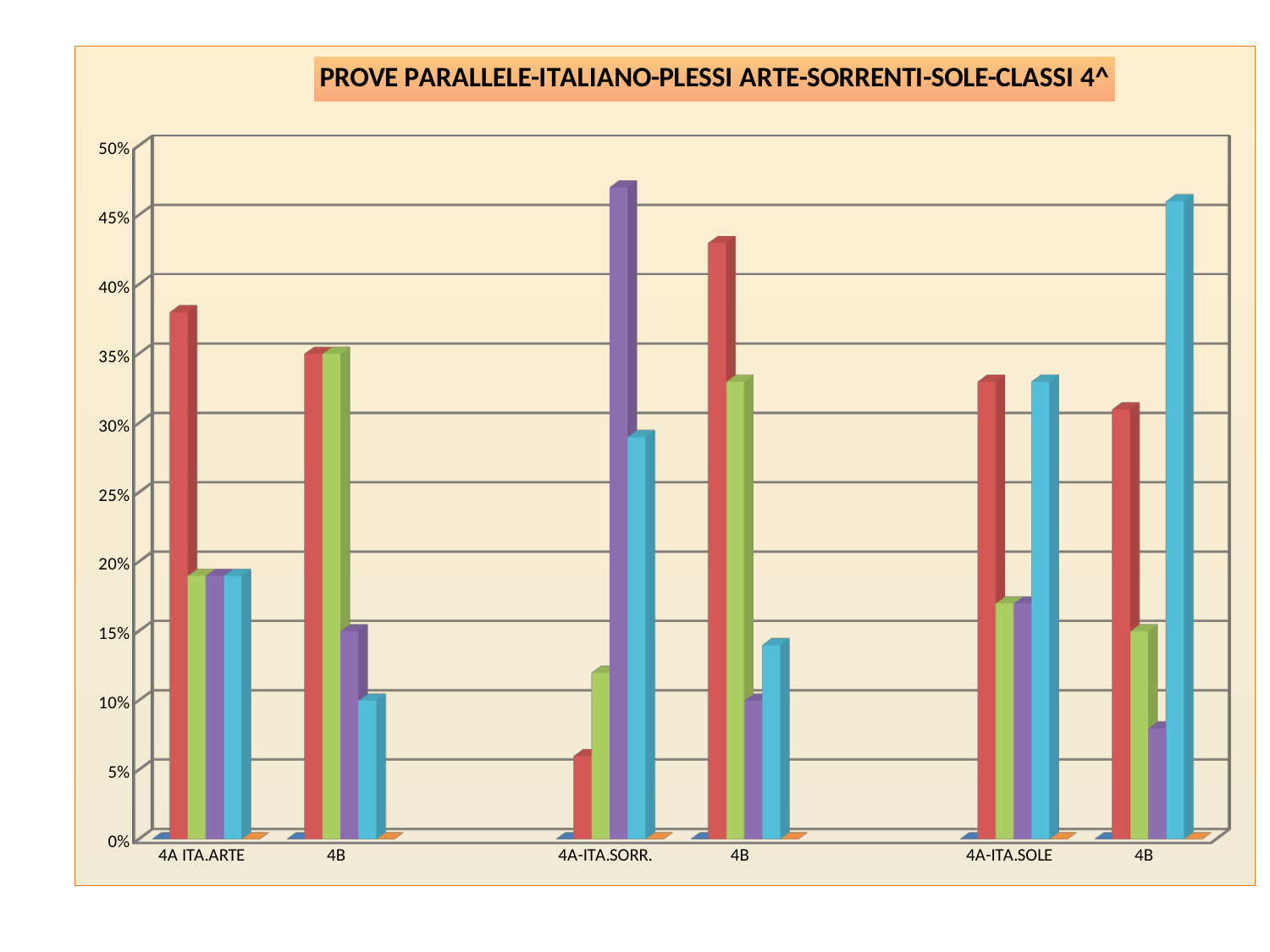
For 4A-ITA.SORR., which is larger: the purple bar or the light blue bar? the purple bar Is the value of the light blue bar for the rightmost 4B category greater or less than 40%? greater Is the value of the red bar for 4A-ITA.SORR. greater or less than 10%? less How many categories are shown along the x axis of the chart? 6 Which category has the lowest red bar? 4A-ITA.SORR. Is the value of the green bar for 4A-ITA.SOLE greater or less than 20%? less What is the title of the chart? PROVE PARALLELE-ITALIANO-PLESSI ARTE-SORRENTI-SOLE-CLASSI 4^ Which category has the tallest purple bar? 4A-ITA.SORR. For 4A ITA.ARTE, which is larger: the red bar or the green bar? the red bar What kind of chart is shown on the slide? bar chart